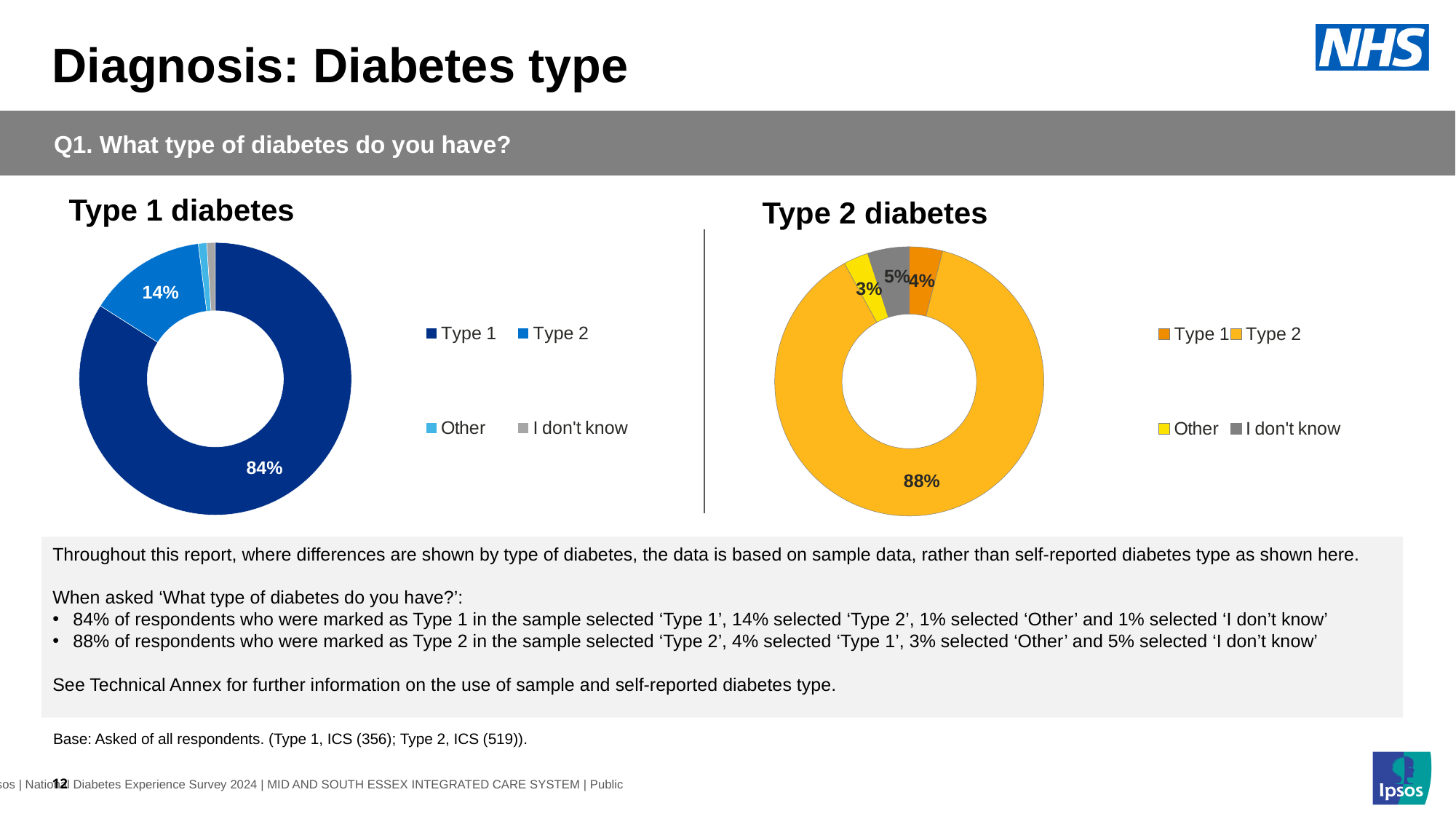
What kind of chart is used on this slide to show diabetes type? Donut (pie) chart How many categories does the legend of the 'Type 2 diabetes' chart list? 4 In the 'Type 2 diabetes' chart, what percentage selected 'Type 2'? 88% In the 'Type 2 diabetes' chart, what percentage selected 'I don't know'? 5% In the 'Type 1 diabetes' chart, what percentage selected 'Type 2'? 14% In the 'Type 2 diabetes' chart, which category has the smallest share? Other In the 'Type 2 diabetes' chart, what percentage selected 'Other'? 3% In the 'Type 1 diabetes' chart, what percentage selected 'Type 1'? 84% In the 'Type 1 diabetes' chart, what is the difference between the 'Type 1' and 'Type 2' shares? 70 percentage points In the 'Type 2 diabetes' chart, what percentage selected 'Type 1'? 4% In the 'Type 1 diabetes' chart, which category has the largest share? Type 1 In the 'Type 2 diabetes' chart, which is larger: the share for 'I don't know' or the share for 'Type 1'? I don't know